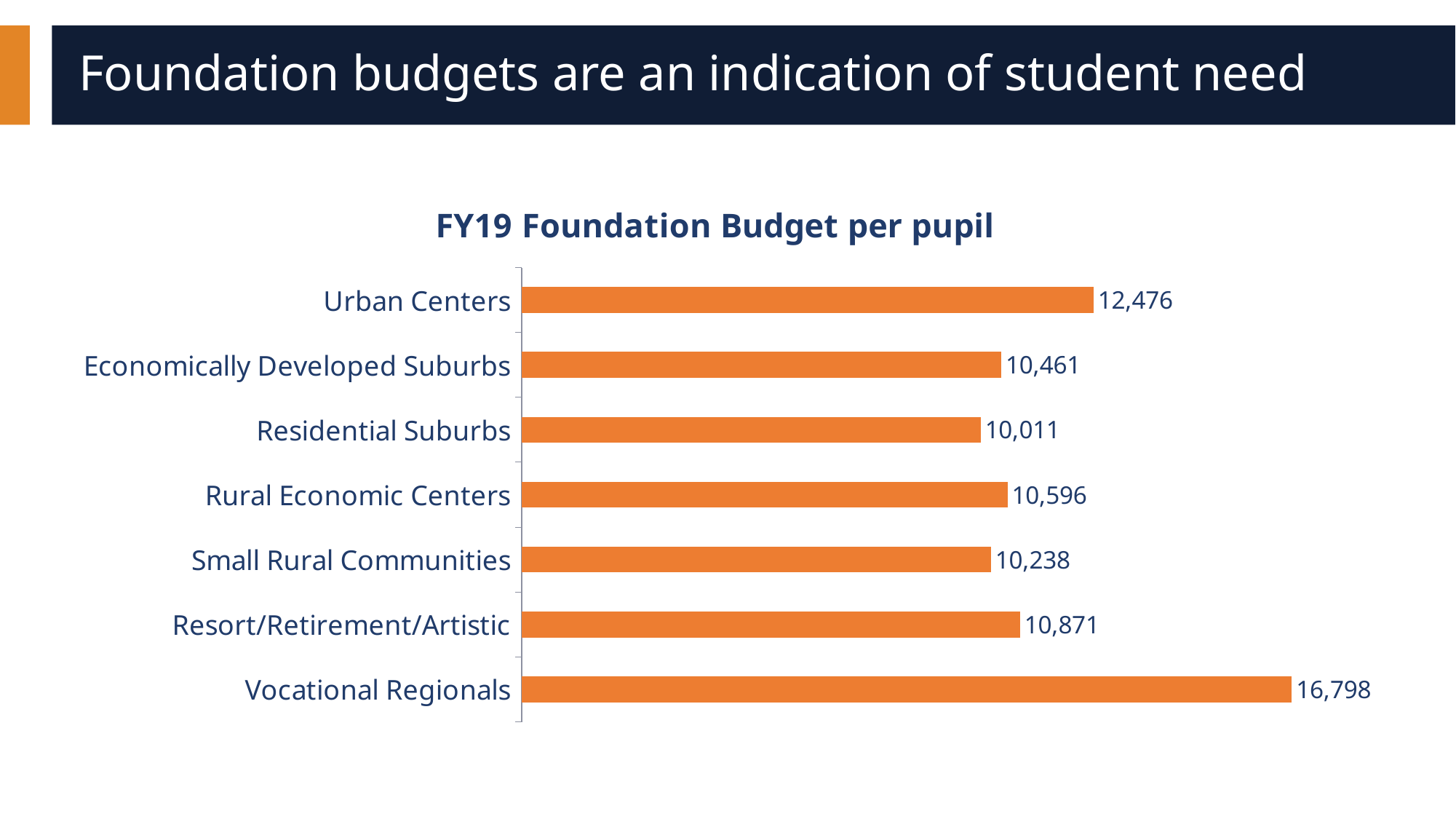
What is the title of the chart on the slide? FY19 Foundation Budget per pupil What kind of chart is used to show the FY19 Foundation Budget per pupil? Bar chart Which has a larger FY19 Foundation Budget per pupil, Economically Developed Suburbs or Resort/Retirement/Artistic? Resort/Retirement/Artistic What is the difference between the FY19 Foundation Budget per pupil for Rural Economic Centers and Small Rural Communities? 358 Which category has the lowest FY19 Foundation Budget per pupil? Residential Suburbs What is the FY19 Foundation Budget per pupil for Resort/Retirement/Artistic? 10,871 Which category has the highest FY19 Foundation Budget per pupil? Vocational Regionals What is the FY19 Foundation Budget per pupil for Urban Centers? 12,476 What is the FY19 Foundation Budget per pupil for Vocational Regionals? 16,798 What is the FY19 Foundation Budget per pupil for Residential Suburbs? 10,011 What is the difference between the FY19 Foundation Budget per pupil for Vocational Regionals and Urban Centers? 4,322 How many categories are shown in the FY19 Foundation Budget per pupil chart? 7